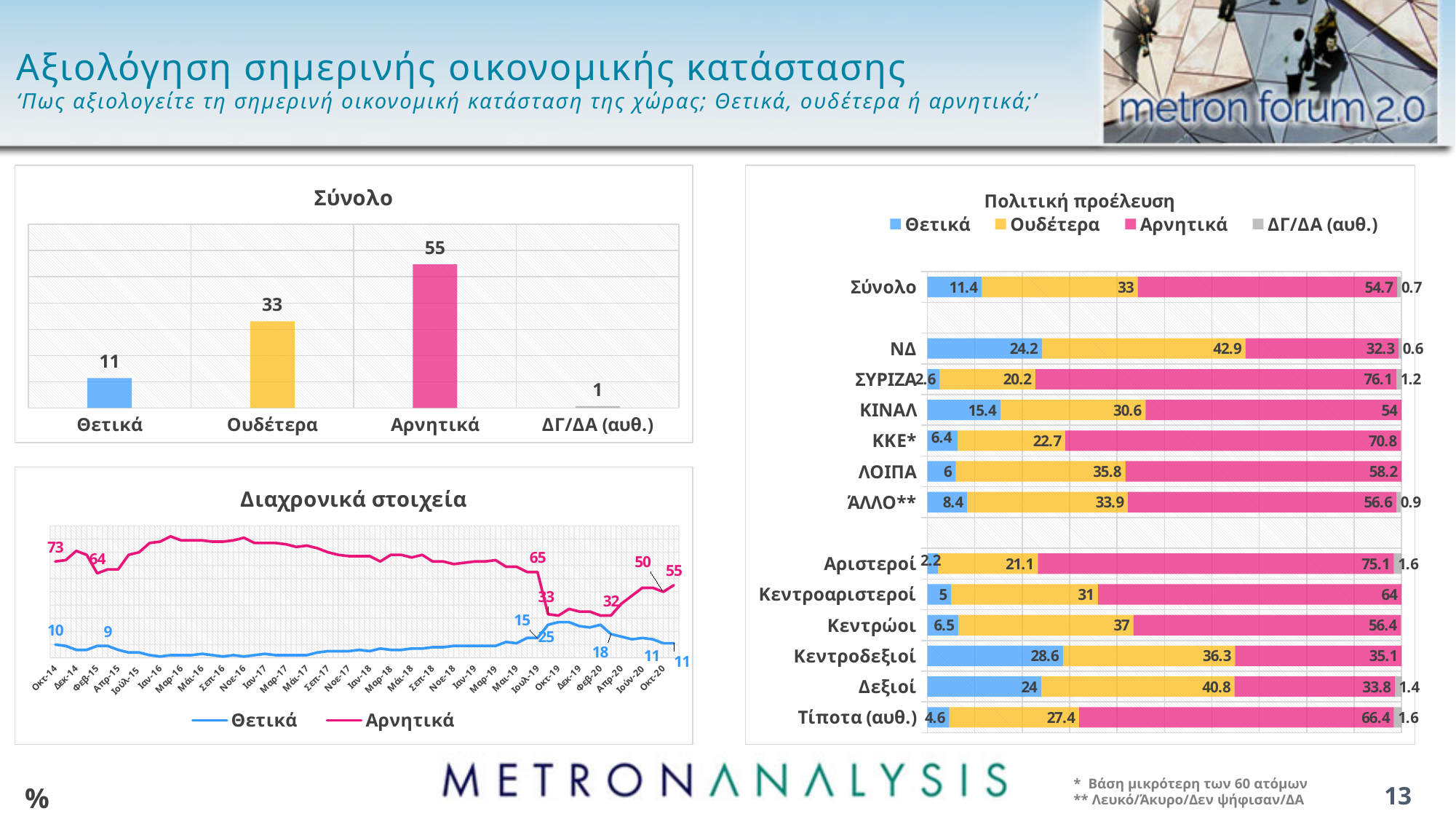
In the 'Σύνολο' chart, which category has the lowest value? ΔΓ/ΔΑ (αυθ.) In the 'Πολιτική προέλευση' chart, what is the Ουδέτερα value for ΝΔ? 42.9 How many series does the legend of the 'Διαχρονικά στοιχεία' chart list? 2 In the 'Διαχρονικά στοιχεία' chart, what is the value of Θετικά at Οκτ-14? 10 In the 'Σύνολο' chart, what is the difference between Αρνητικά and Ουδέτερα? 22 In the 'Διαχρονικά στοιχεία' chart, what is the value of Αρνητικά at Οκτ-20? 50 In the 'Πολιτική προέλευση' chart, which category has the highest Θετικά value? Κεντροδεξιοί In the 'Πολιτική προέλευση' chart, is the Αρνητικά value larger for ΚΚΕ* or for ΚΙΝΑΛ? ΚΚΕ* How many series does the legend of the 'Πολιτική προέλευση' chart list? 4 In the 'Σύνολο' chart, what is the value for Αρνητικά? 55 What kind of chart is the 'Σύνολο' chart? bar chart In the 'Πολιτική προέλευση' chart, which category has the highest Αρνητικά value? ΣΥΡΙΖΑ